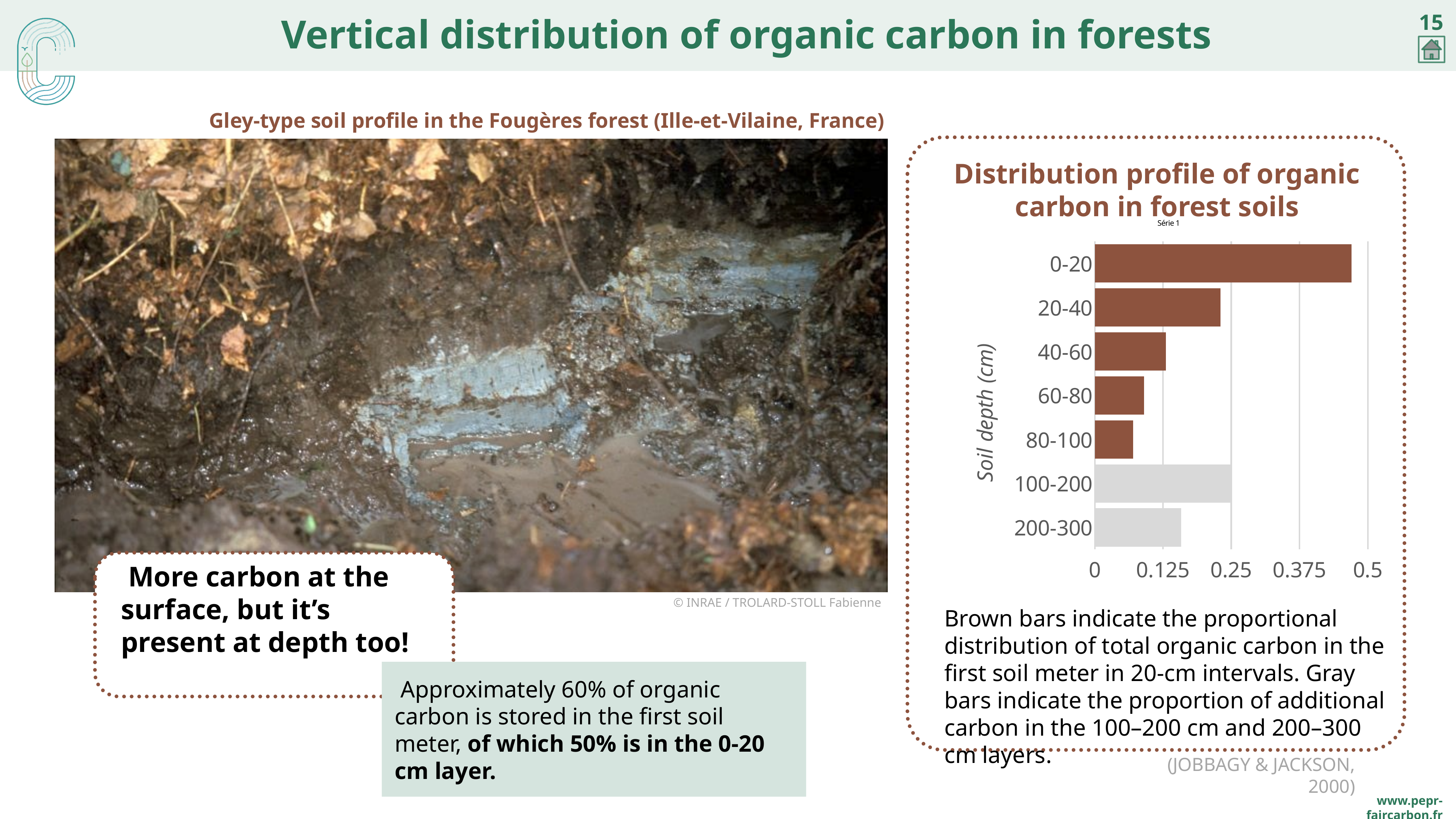
Which has the larger value, the 100-200 cm layer or the 200-300 cm layer? 100-200 Which soil depth category has the highest value in the chart? 0-20 Which soil depth category has the lowest value in the chart? 80-100 What is the label of the vertical axis of the chart? Soil depth (cm) Is the value for the 60-80 cm layer greater or less than 0.125? less Is the value for the 0-20 cm layer greater or less than 0.375? greater How many soil depth categories are plotted in the chart? 7 What kind of chart is shown under the title "Distribution profile of organic carbon in forest soils"? bar chart Do the brown bars rise or fall as soil depth increases from 0-20 to 80-100 cm? fall Which has the larger value, the 0-20 cm layer or the 20-40 cm layer? 0-20 Is the value for the 200-300 cm layer greater or less than 0.125? greater